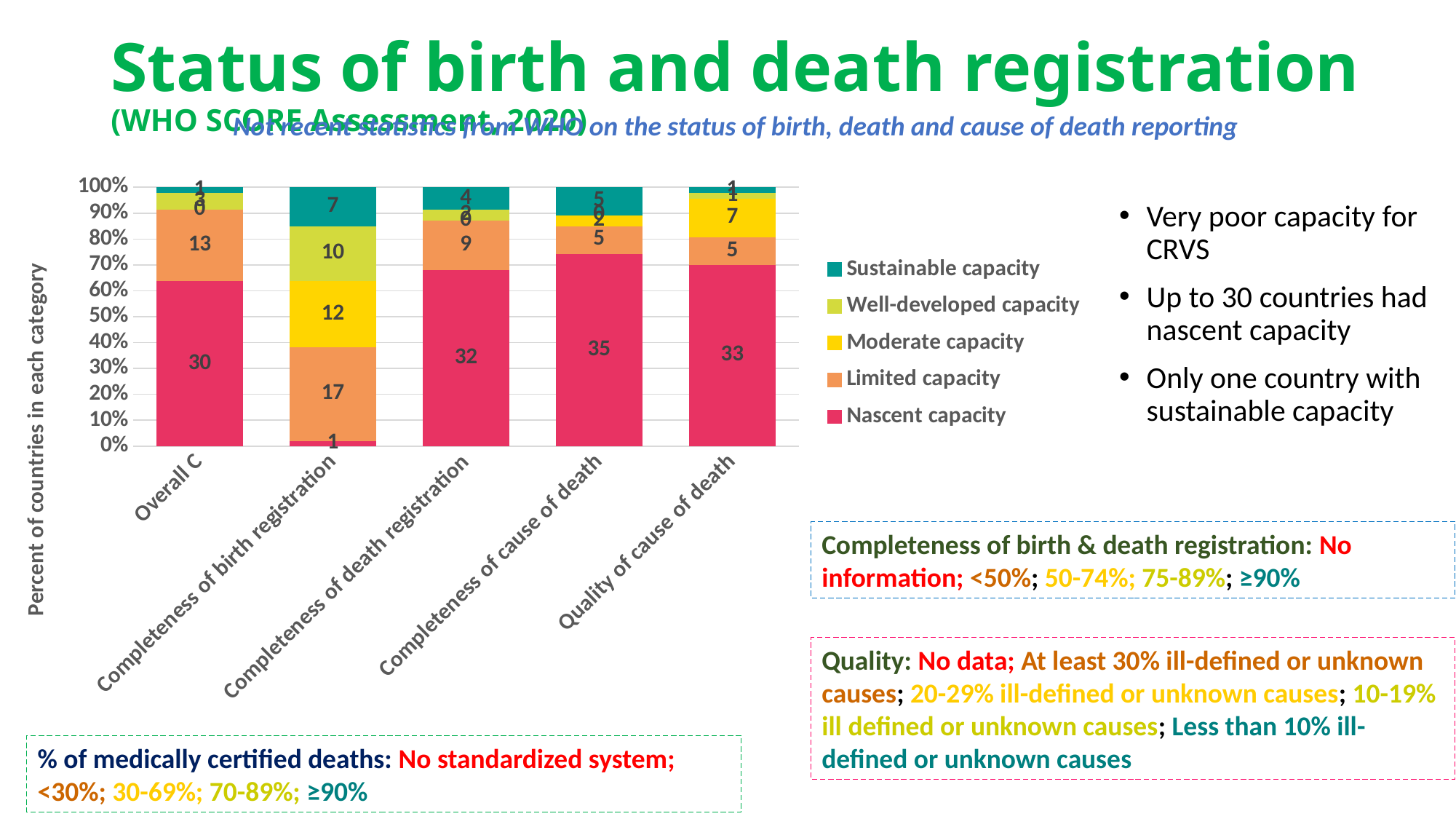
Which has more countries with Moderate capacity: Completeness of birth registration or Quality of cause of death? Completeness of birth registration What is the difference between the Limited capacity counts for Completeness of birth registration and Completeness of death registration? 8 How many countries have Nascent capacity for Completeness of birth registration? 1 How many countries have Nascent capacity for Completeness of cause of death? 35 Which category has the lowest number of countries with Nascent capacity? Completeness of birth registration Is the Nascent capacity share for Completeness of death registration greater or less than 60%? greater How many countries have Sustainable capacity for Completeness of birth registration? 7 How many series does the legend list? 5 Which category has the highest number of countries with Nascent capacity? Completeness of cause of death How many countries have Limited capacity for Completeness of birth registration? 17 What kind of chart is shown on the slide? Stacked bar chart How many countries have Moderate capacity for Completeness of birth registration? 12